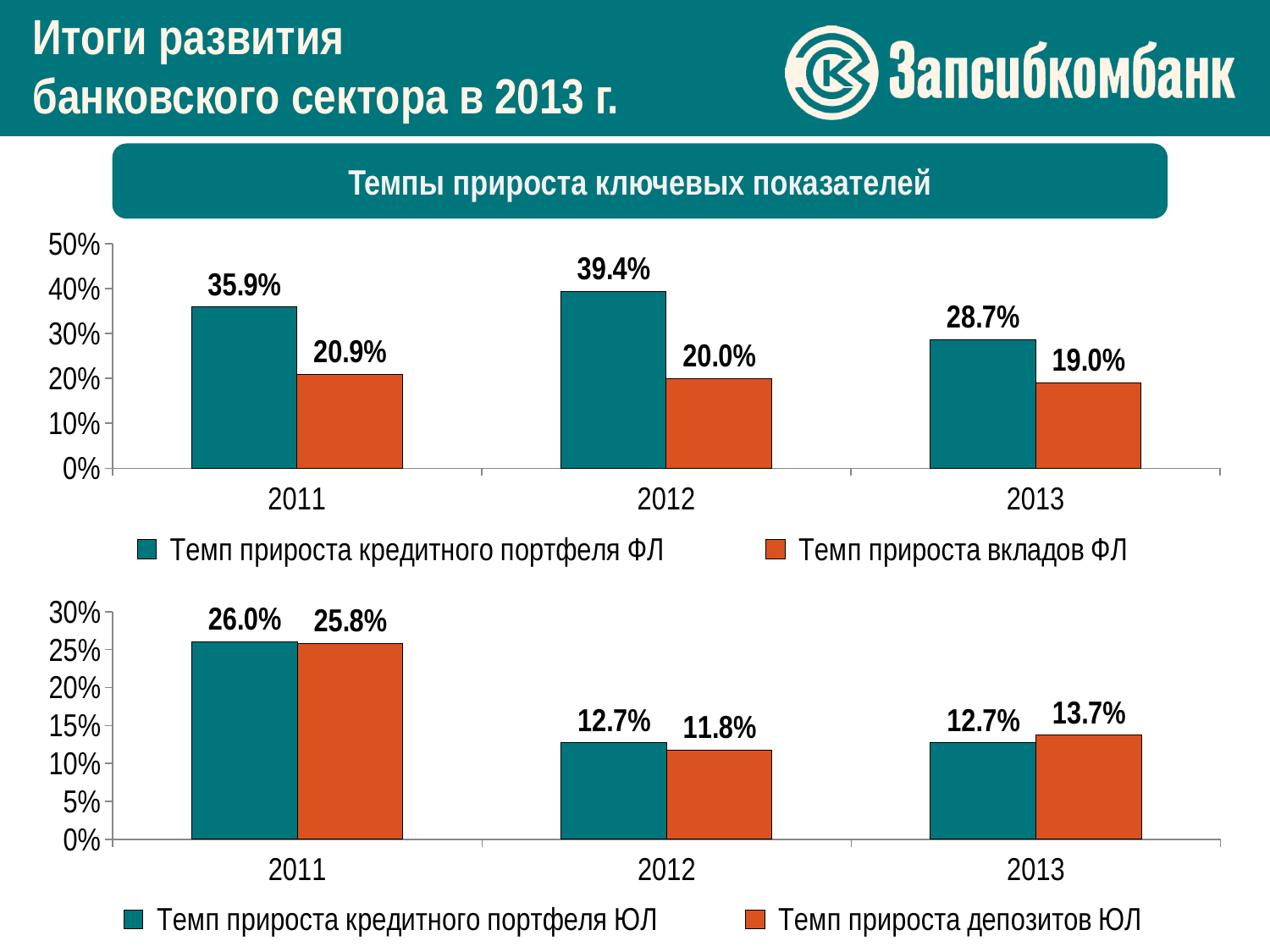
How many series does the legend of the top chart list? 2 In the top chart, what is the value of Темп прироста кредитного портфеля ФЛ for 2012? 39.4% In the top chart, is the value of Темп прироста кредитного портфеля ФЛ for 2013 greater or less than 30%? less In the top chart, what is the value of Темп прироста вкладов ФЛ for 2013? 19.0% In the bottom chart, what is the value of Темп прироста депозитов ЮЛ for 2011? 25.8% How many years are shown on the x axis of the bottom chart? 3 In the top chart, what is the difference between Темп прироста кредитного портфеля ФЛ and Темп прироста вкладов ФЛ in 2011? 15.0% What type of chart is the bottom chart? Bar chart In the top chart, which year has the highest value for Темп прироста кредитного портфеля ФЛ? 2012 In the bottom chart, does Темп прироста кредитного портфеля ЮЛ rise or fall from 2011 to 2012? Fall In the bottom chart, which is larger in 2013: Темп прироста кредитного портфеля ЮЛ or Темп прироста депозитов ЮЛ? Темп прироста депозитов ЮЛ In the bottom chart, which year has the lowest value for Темп прироста депозитов ЮЛ? 2012